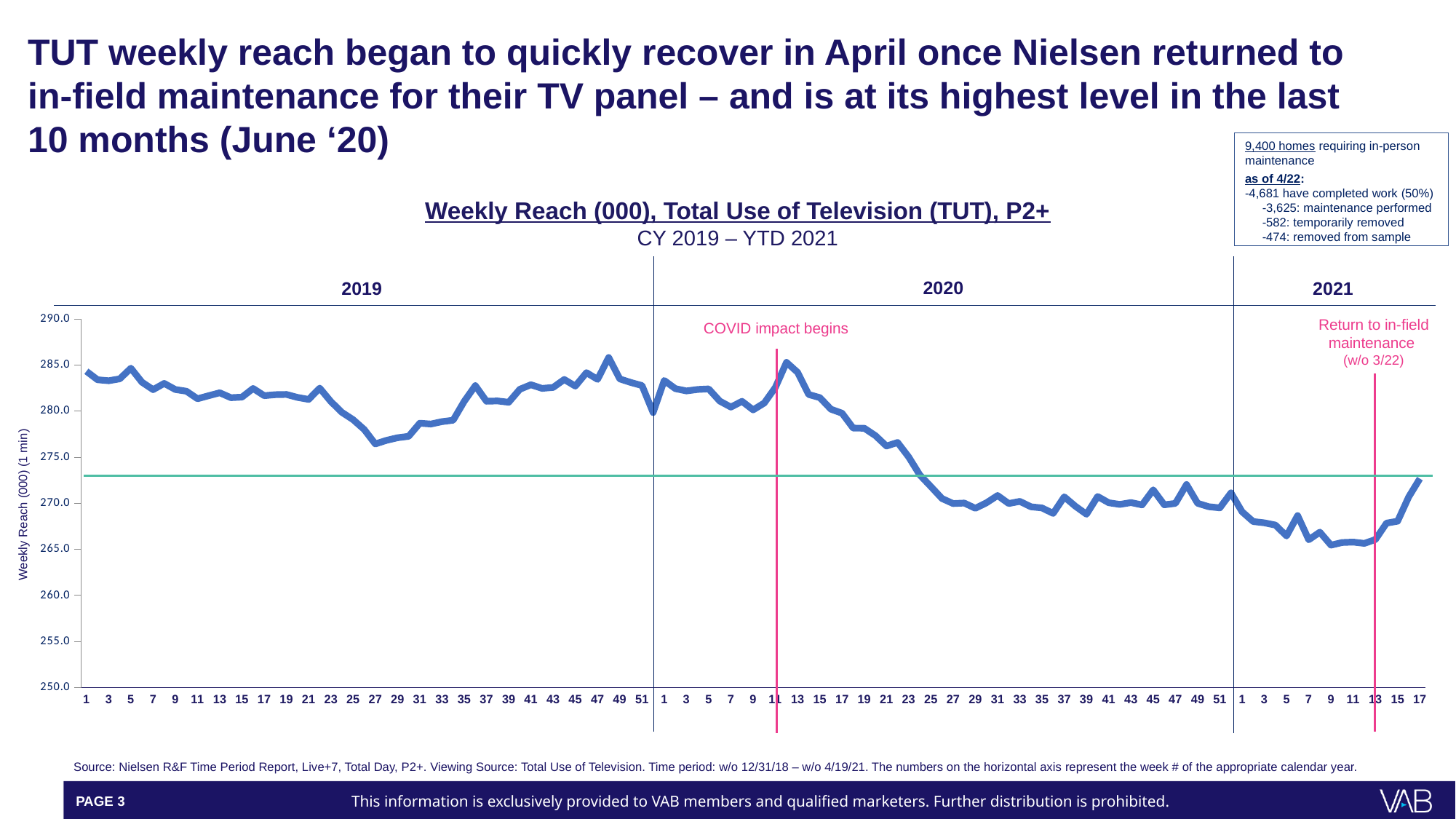
Which is larger, the weekly reach for week 12 of 2020 or for week 29 of 2020? week 12 of 2020 Do the weekly reach values rise or fall between week 13 and week 17 of 2021? rise What is the title of the chart? Weekly Reach (000), Total Use of Television (TUT), P2+ What time period does the chart subtitle say it covers? CY 2019 – YTD 2021 Is the weekly reach value for week 27 of 2019 greater or less than 280? less What kind of chart is shown on the slide? line chart Which is larger, the weekly reach for week 1 of 2019 or for week 1 of 2021? week 1 of 2019 Is the weekly reach value for week 1 of 2019 greater or less than 280? greater Is the weekly reach value for week 17 of 2021 greater or less than 270? greater Do the weekly reach values rise or fall between week 13 and week 25 of 2020? fall How many calendar years are shown along the x axis of the chart? 3